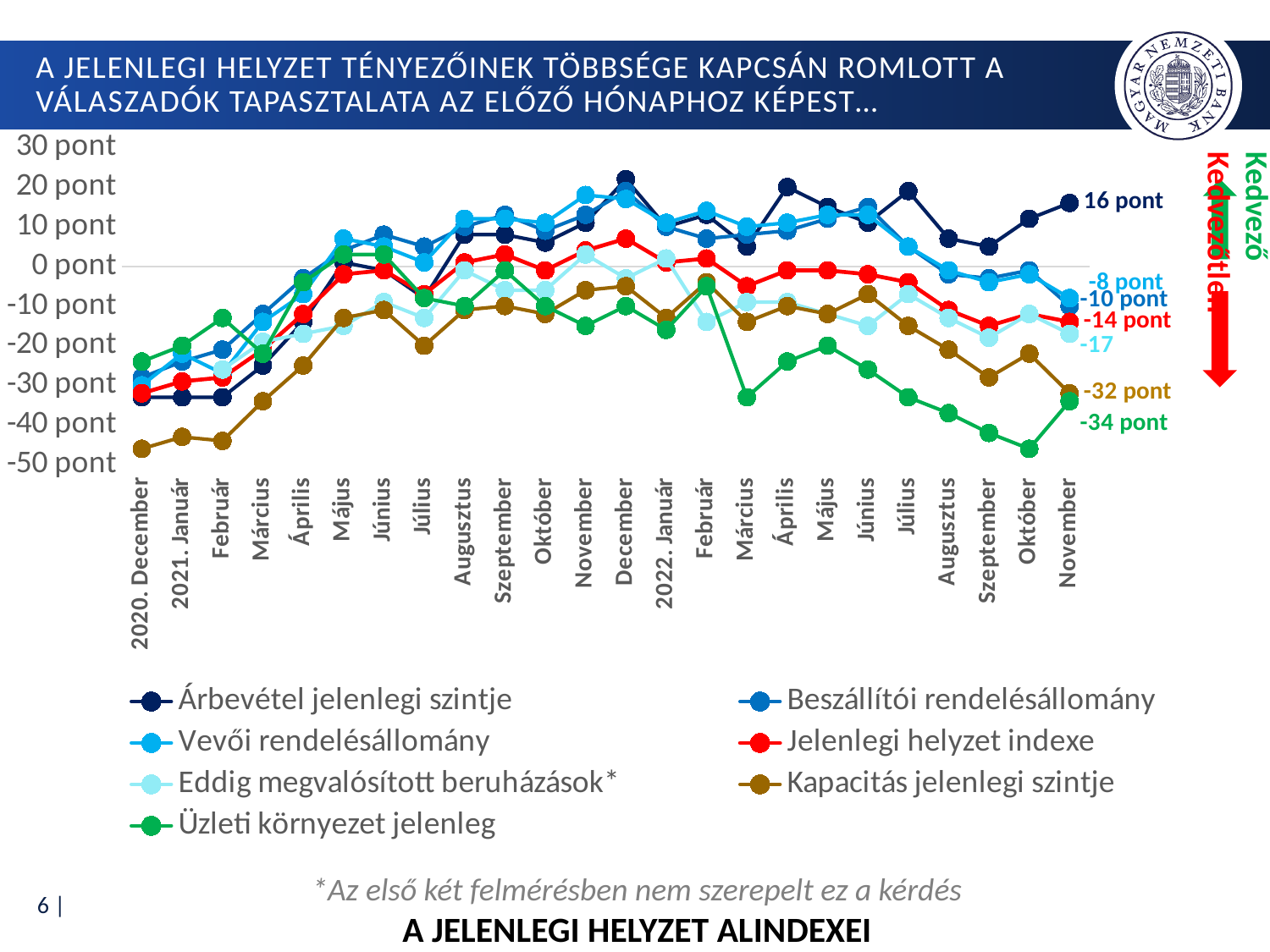
What is the value of Üzleti környezet jelenleg in 2022 November? -34 pont What is the difference between Árbevétel jelenlegi szintje (16 pont) and Jelenlegi helyzet indexe (-14 pont) in 2022 November? 30 pont Which series has the lowest value in 2022 November? Üzleti környezet jelenleg How many series does the legend list? 7 What is the value of Kapacitás jelenlegi szintje in 2022 November? -32 pont What is the value of Árbevétel jelenlegi szintje in 2022 November? 16 pont What type of chart is shown on the slide? line chart Does the Üzleti környezet jelenleg series rise or fall between 2022 Február and 2022 Október? fall Is the value of Kapacitás jelenlegi szintje in 2020 December greater or less than -40 pont? less How many months are shown on the x axis? 24 Which series has the highest value in 2022 November? Árbevétel jelenlegi szintje What is the value of Jelenlegi helyzet indexe in 2022 November? -14 pont